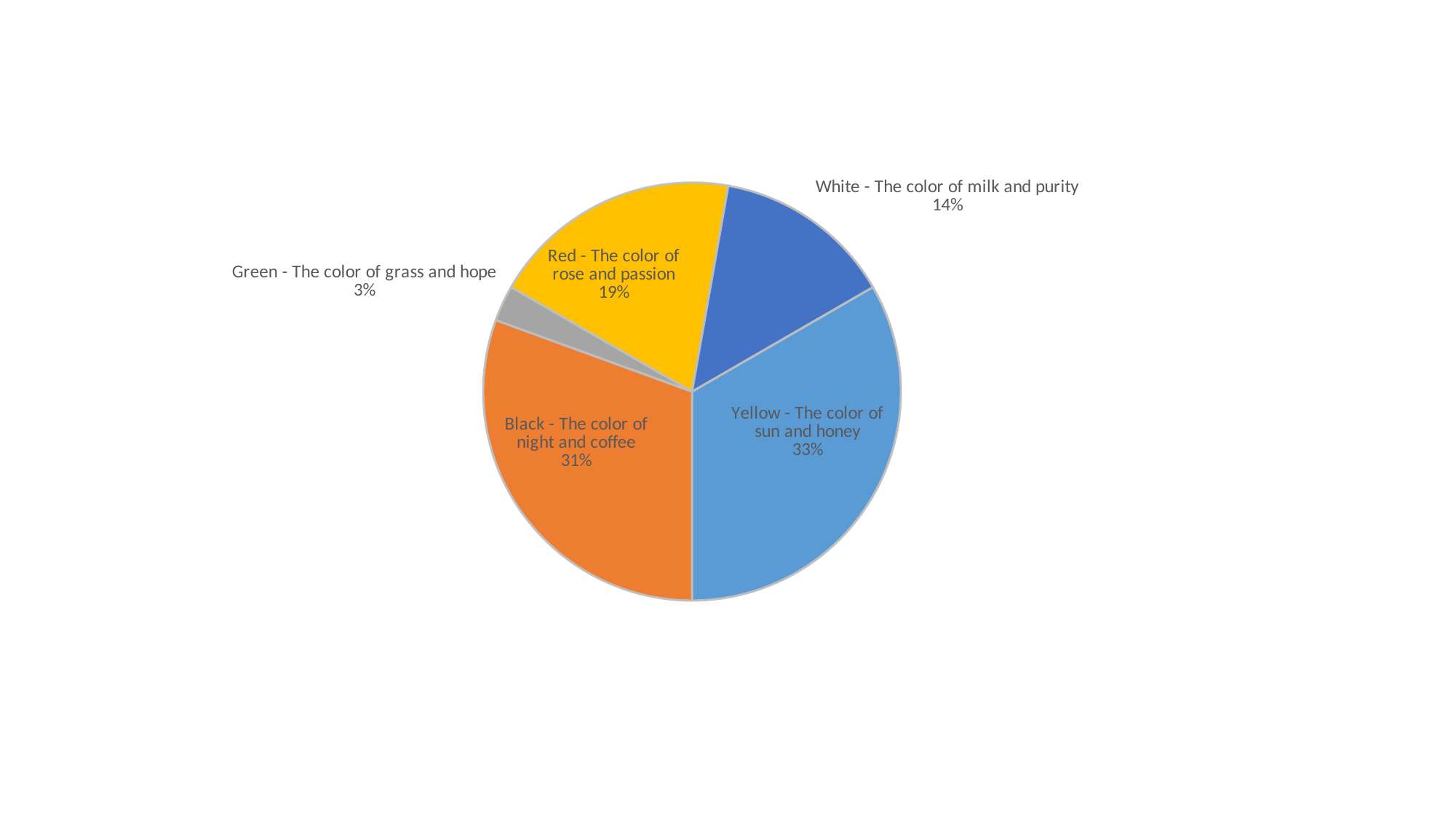
What is the difference in percentage points between the 'Yellow - The color of sun and honey' slice and the 'Black - The color of night and coffee' slice? 2 percentage points Which slice is larger: 'Red - The color of rose and passion' or 'White - The color of milk and purity'? Red - The color of rose and passion What kind of chart is shown on the slide? Pie chart What share of the pie does the slice 'Red - The color of rose and passion' have? 19% What share of the pie does the slice 'Green - The color of grass and hope' have? 3% How many slices does the pie chart have? 5 What share of the pie does the slice 'White - The color of milk and purity' have? 14% Which slice has the smallest share of the pie? Green - The color of grass and hope What colour is the slice labelled 'Black - The color of night and coffee'? Orange Which slice has the largest share of the pie? Yellow - The color of sun and honey